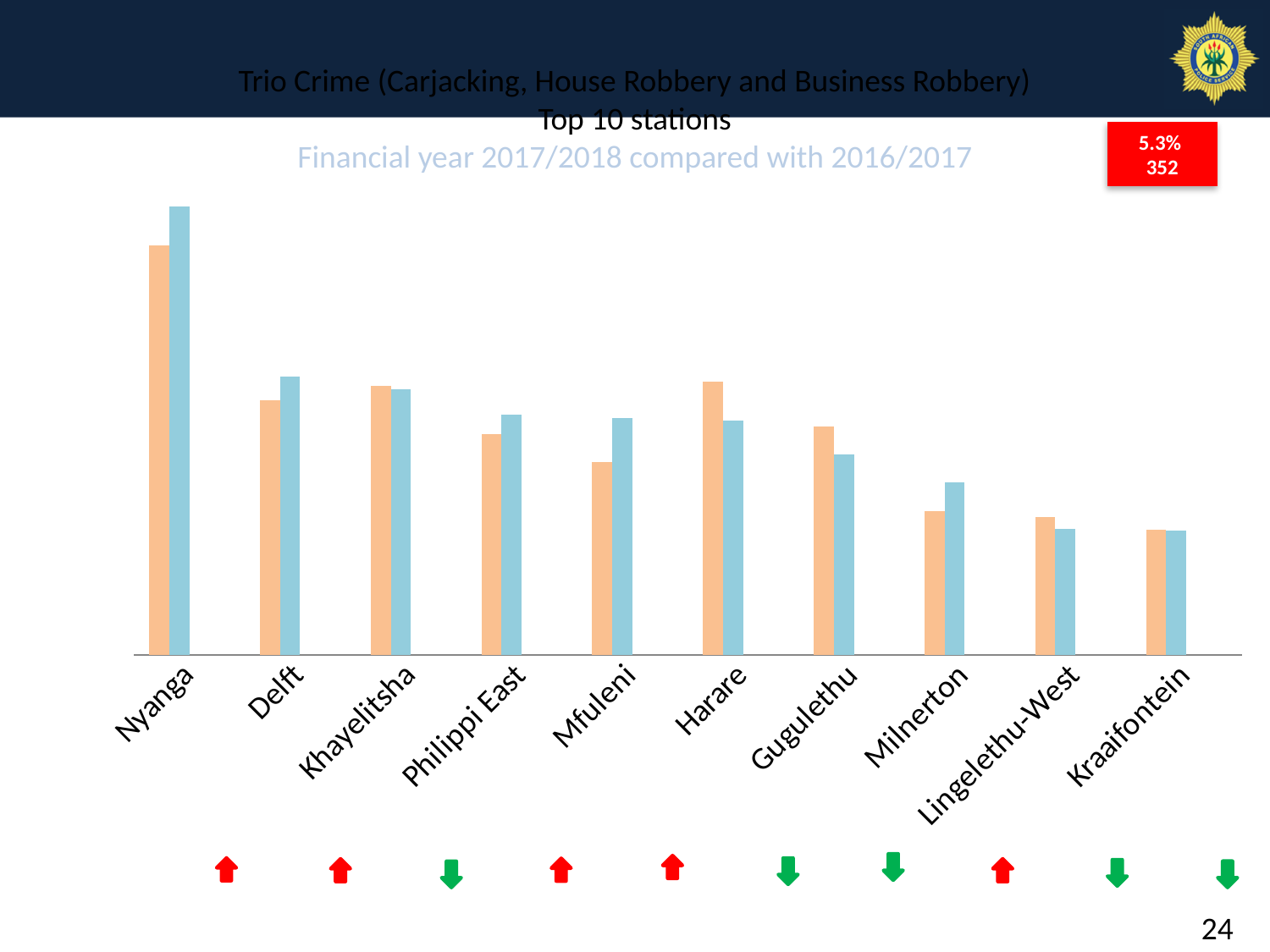
Do the bar heights generally rise or fall from left to right across the stations? fall Which station has taller bars, Harare or Milnerton? Harare How many stations are shown on the x axis of the chart? 10 For Harare, which bar is taller, the orange bar or the blue bar? the orange bar Which station has the highest bars in the chart? Nyanga Which station has taller bars, Nyanga or Delft? Nyanga Which station is listed last on the x axis? Kraaifontein Which station is listed first on the x axis? Nyanga How many bars are plotted for each station in the chart? 2 What kind of chart is shown on the slide? bar chart